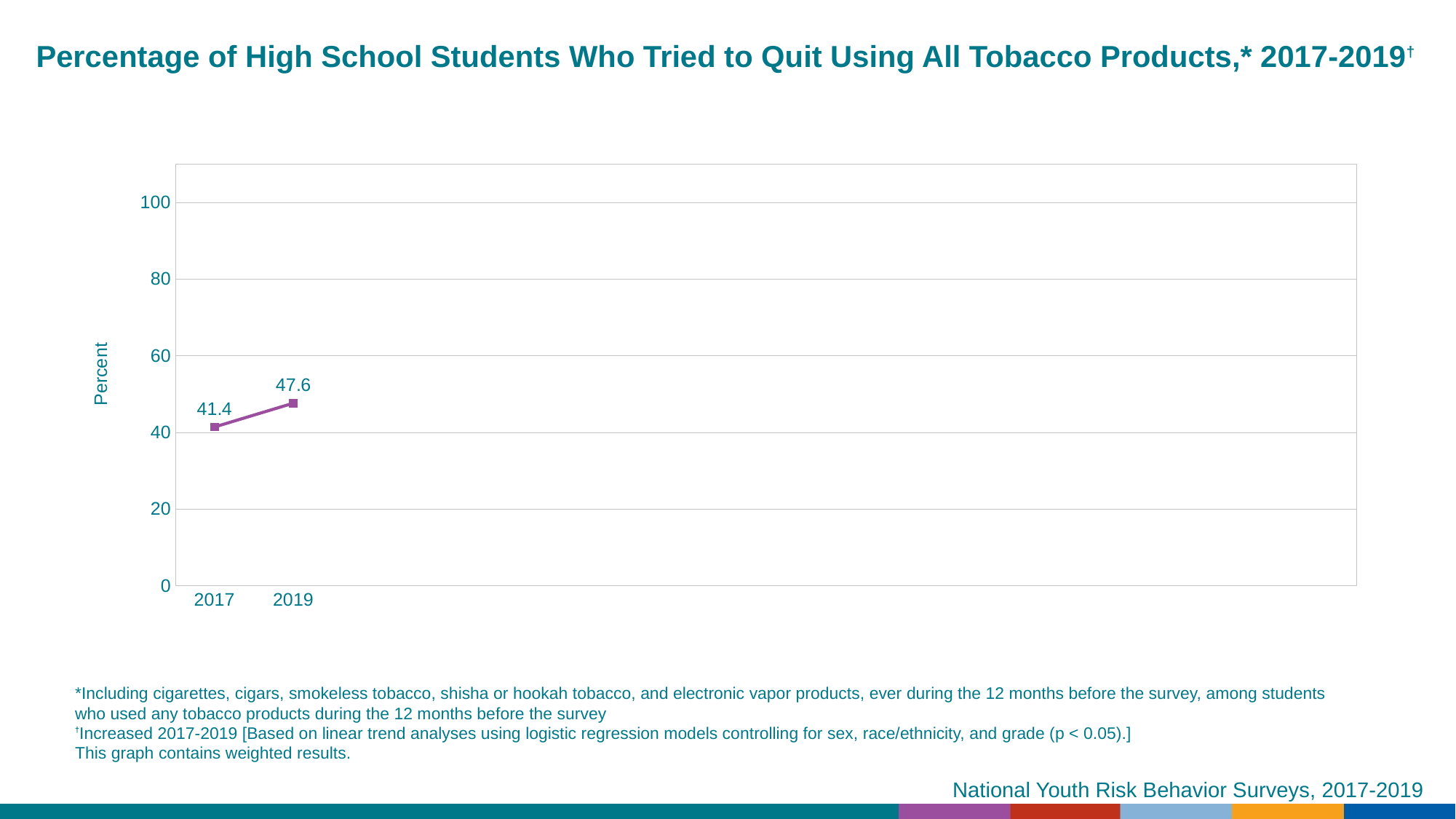
What is the value for 2017? 41.4 Which year has the higher value? 2019 Do the values rise or fall from 2017 to 2019? Rise How many data points are plotted on the chart? 2 Which year has the lower value? 2017 What is the difference between the 2019 and 2017 values? 6.2 What kind of chart is shown on the slide? Line chart Is the value for 2019 larger than the value for 2017? Yes What is the label on the vertical axis? Percent Is the value for 2017 greater or less than 60? less Is the value for 2019 greater or less than 40? greater What is the value for 2019? 47.6